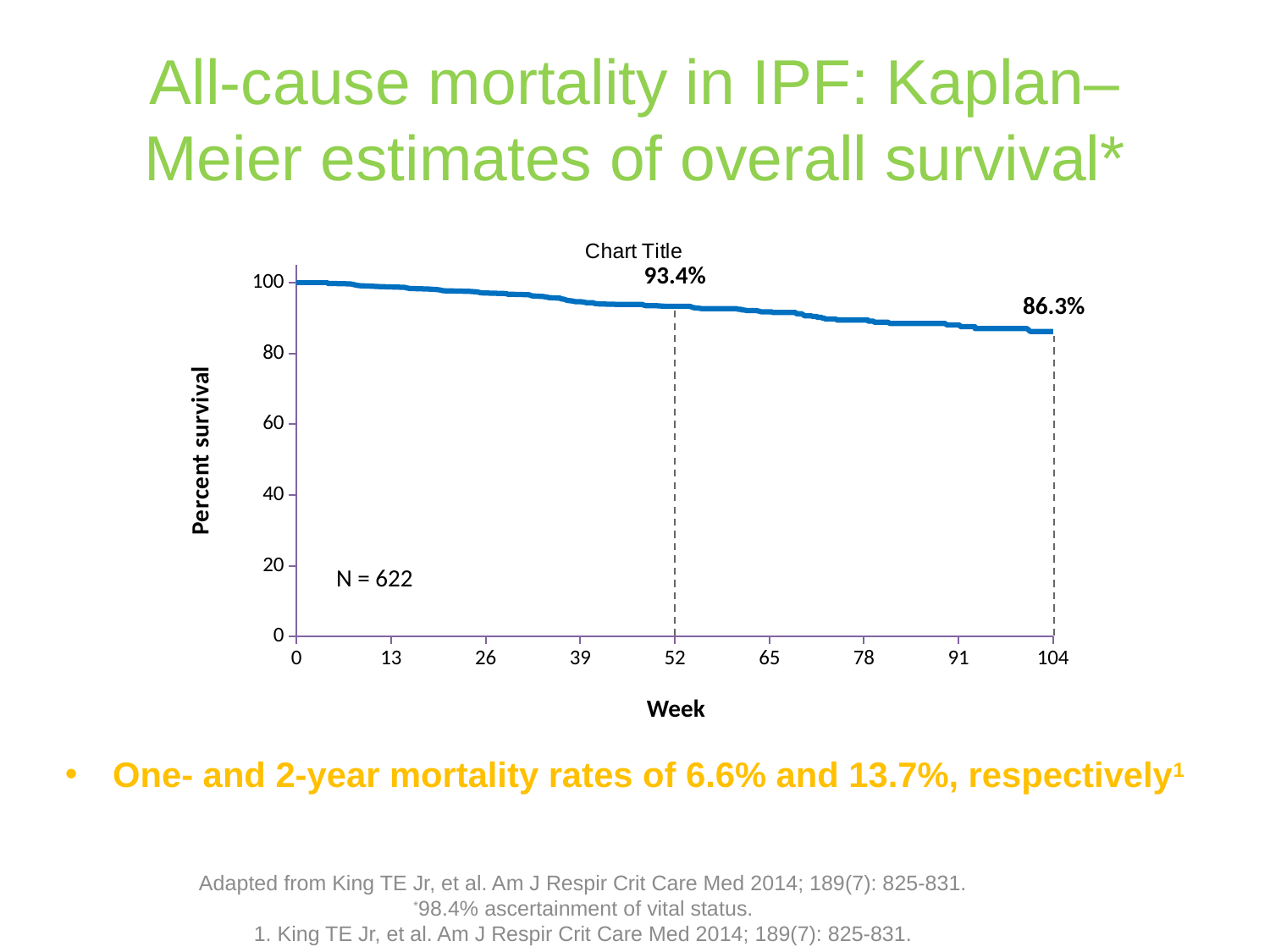
What is the percent survival at week 52? 93.4% Is the percent survival at week 26 greater or less than 80? greater What is the percent survival at week 104? 86.3% What is the label of the y axis? Percent survival What is the difference in percent survival between week 52 and week 104? 7.1% Which is larger, the percent survival at week 52 or at week 104? Week 52 What is the sample size (N) shown on the chart? N = 622 What is the highest week value shown on the x axis? 104 Does percent survival rise or fall as the weeks increase? Fall Is the percent survival at week 104 greater or less than 80? greater What is the label of the x axis? Week What kind of chart is shown on the slide? Line chart